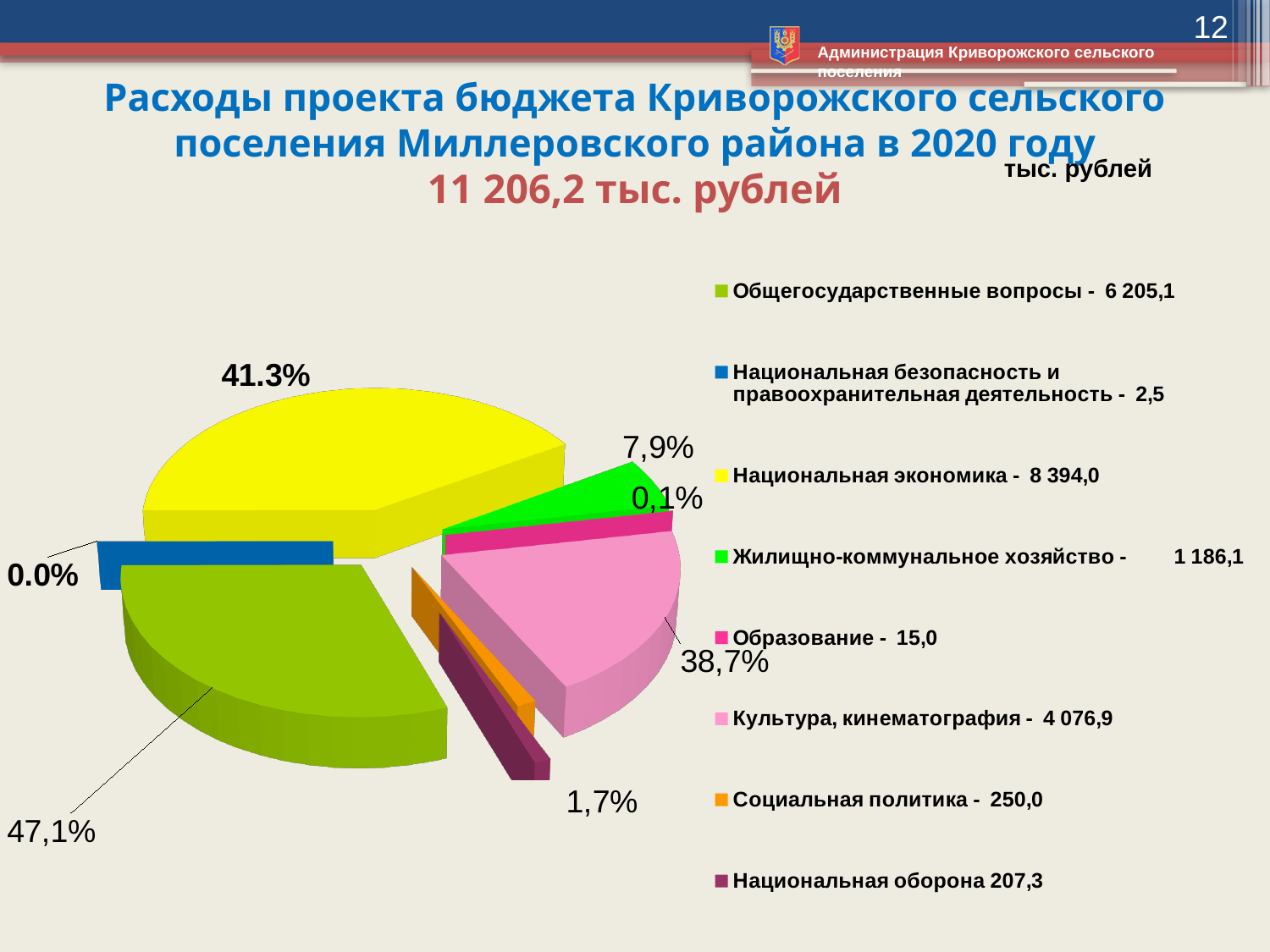
What value is shown in the legend for Культура, кинематография? 4 076,9 What is the difference between the legend values for Национальная экономика and Общегосударственные вопросы? 2 188,9 Which category has the smallest value in the legend? Национальная безопасность и правоохранительная деятельность What kind of chart is shown on the slide? pie chart How many categories does the legend of the pie chart list? 8 What value is shown in the legend for Национальная оборона? 207,3 Which has the larger legend value: Социальная политика or Национальная оборона? Социальная политика What value is shown in the legend for Национальная экономика? 8 394,0 Which category has the largest value in the legend? Национальная экономика What percentage label is shown on the Национальная экономика slice? 41.3% What value is shown in the legend for Общегосударственные вопросы? 6 205,1 What total expenditure amount is stated in the slide title? 11 206,2 тыс. рублей